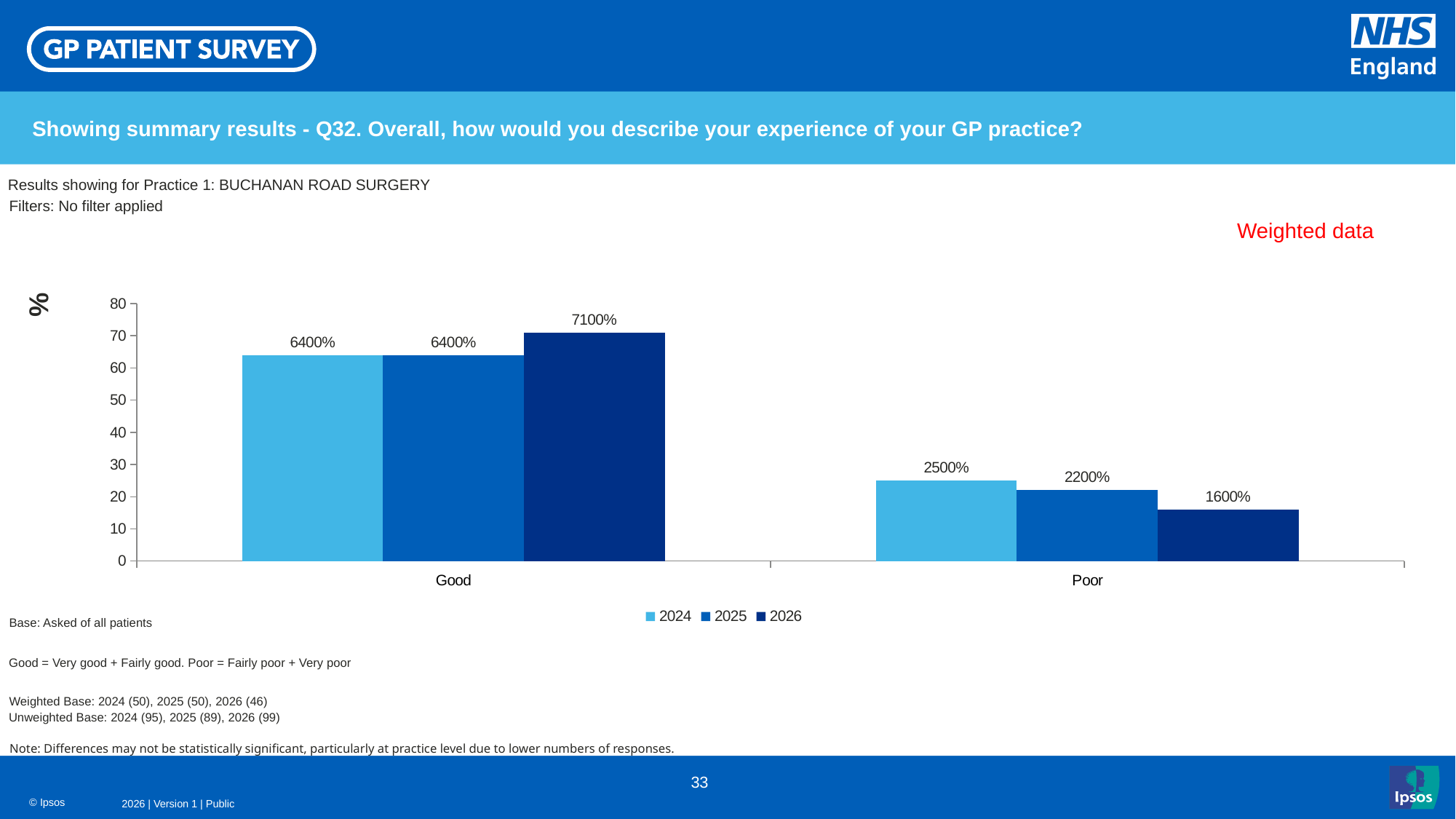
Which year has the highest bar in the Good category? 2026 Is the value for 2026 in the Poor category greater or less than 20 on the axis? less Is the value for 2026 in the Good category greater or less than 70 on the axis? greater What kind of chart is shown on the slide? bar chart Do the Poor bars rise or fall from 2024 to 2026? fall What is the data label shown for 2026 in the Poor category? 1600% How many series does the legend list? 3 Is the 2025 bar for Good larger or smaller than the 2025 bar for Poor? larger What is the data label shown for 2025 in the Poor category? 2200% What is the data label shown for 2024 in the Poor category? 2500% What is the data label shown for 2026 in the Good category? 7100% Which year has the lowest bar in the Poor category? 2026